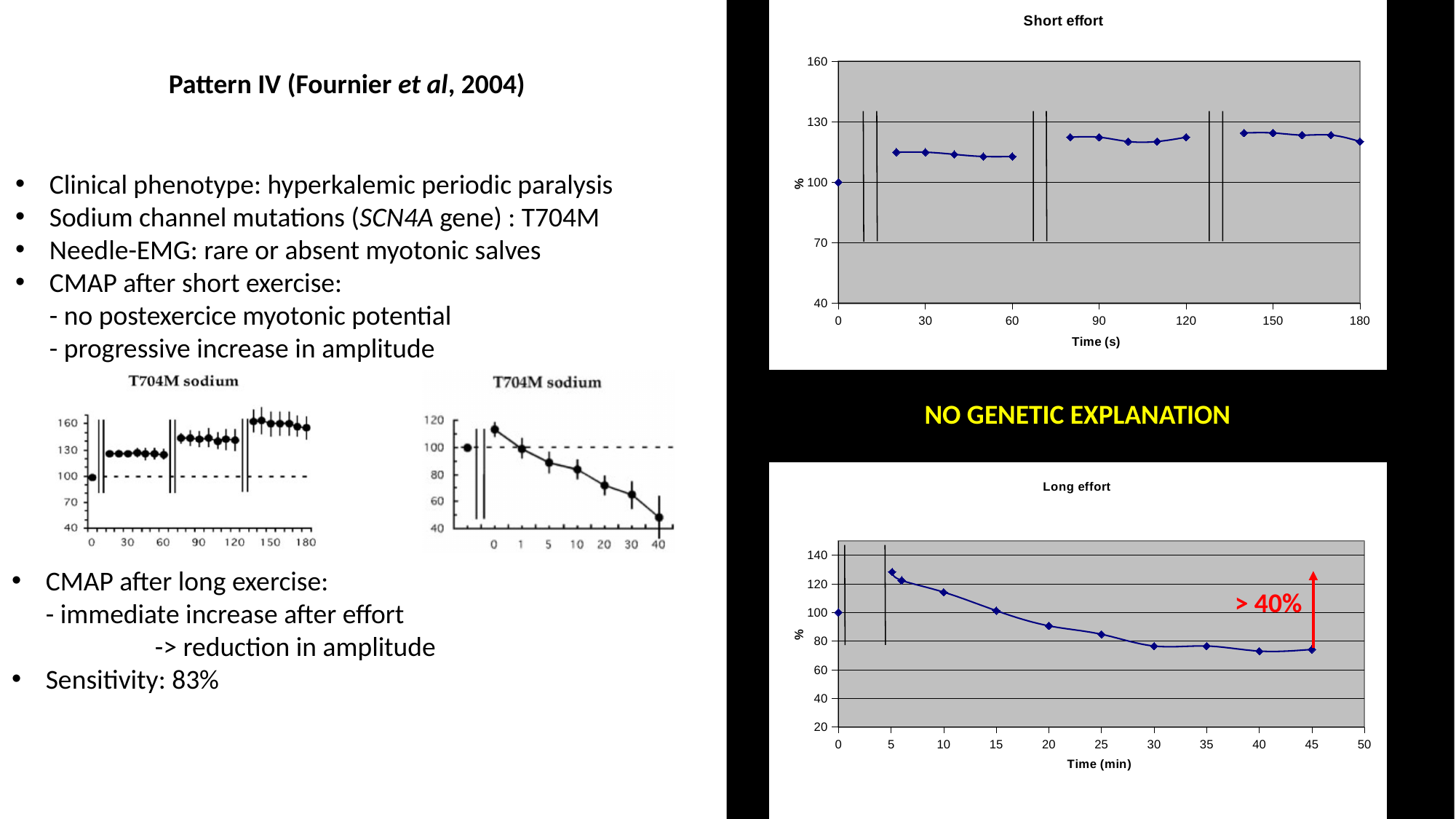
In the 'Long effort' chart, what is the x-axis label? Time (min) In the 'Short effort' chart, is the value at 60 s greater or less than 130? less In the 'Short effort' chart, which is larger: the value at 140 s or the value at 60 s? 140 s In the 'Short effort' chart, what is the % value at time 0? 100 In the 'Long effort' chart, is the value at 5 min greater or less than 120? greater What kind of chart is the 'Short effort' chart? line chart What kind of chart is the 'Long effort' chart? line chart In the 'Short effort' chart, what is the x-axis label? Time (s) In the 'Long effort' chart, what is the % value at time 0? 100 In the 'Long effort' chart, do the values rise or fall from 5 min to 45 min? fall In the 'Long effort' chart, which is larger: the value at 10 min or the value at 30 min? 10 min In the 'Long effort' chart, is the value at 40 min greater or less than 80? less